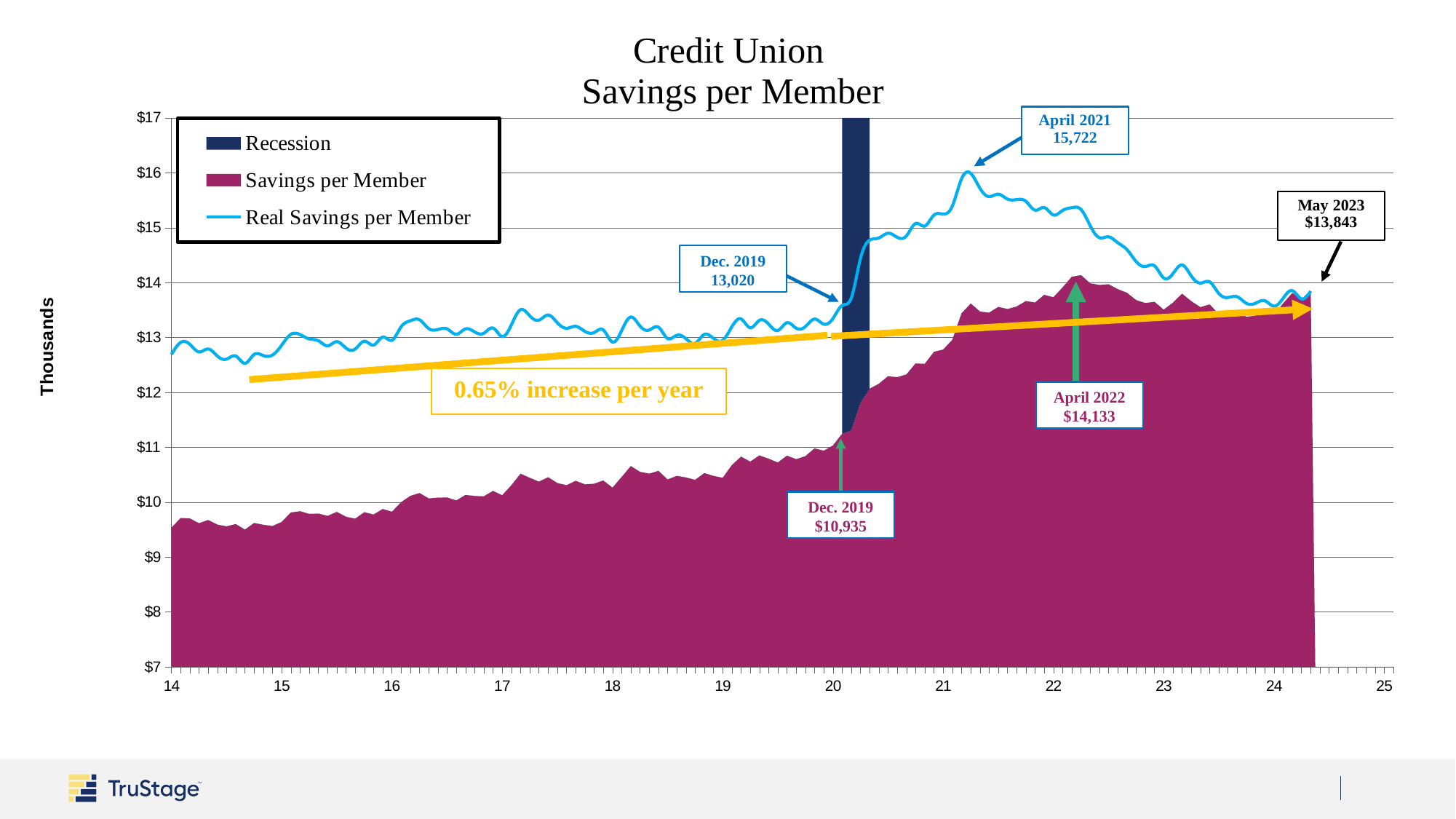
What annual rate of increase is shown by the yellow trend arrow? 0.65% increase per year What is the difference between the Real Savings per Member (13,020) and the Savings per Member ($10,935) labelled for Dec. 2019? 2,085 What is the Savings per Member value labelled for April 2022? $14,133 Is the Savings per Member value at the start of 2014 greater or less than $10? less By how much did Savings per Member rise from the Dec. 2019 label ($10,935) to the April 2022 label ($14,133)? $3,198 What is the Real Savings per Member value labelled for Dec. 2019? 13,020 What kind of chart is shown on the slide? Area chart with a line How many entries does the legend list? 3 Which labelled value is larger: Real Savings per Member in April 2021 or Savings per Member in April 2022? Real Savings per Member in April 2021 What is the Real Savings per Member value labelled for April 2021? 15,722 What value is labelled for May 2023 on the chart? $13,843 What is the Savings per Member value labelled for Dec. 2019? $10,935